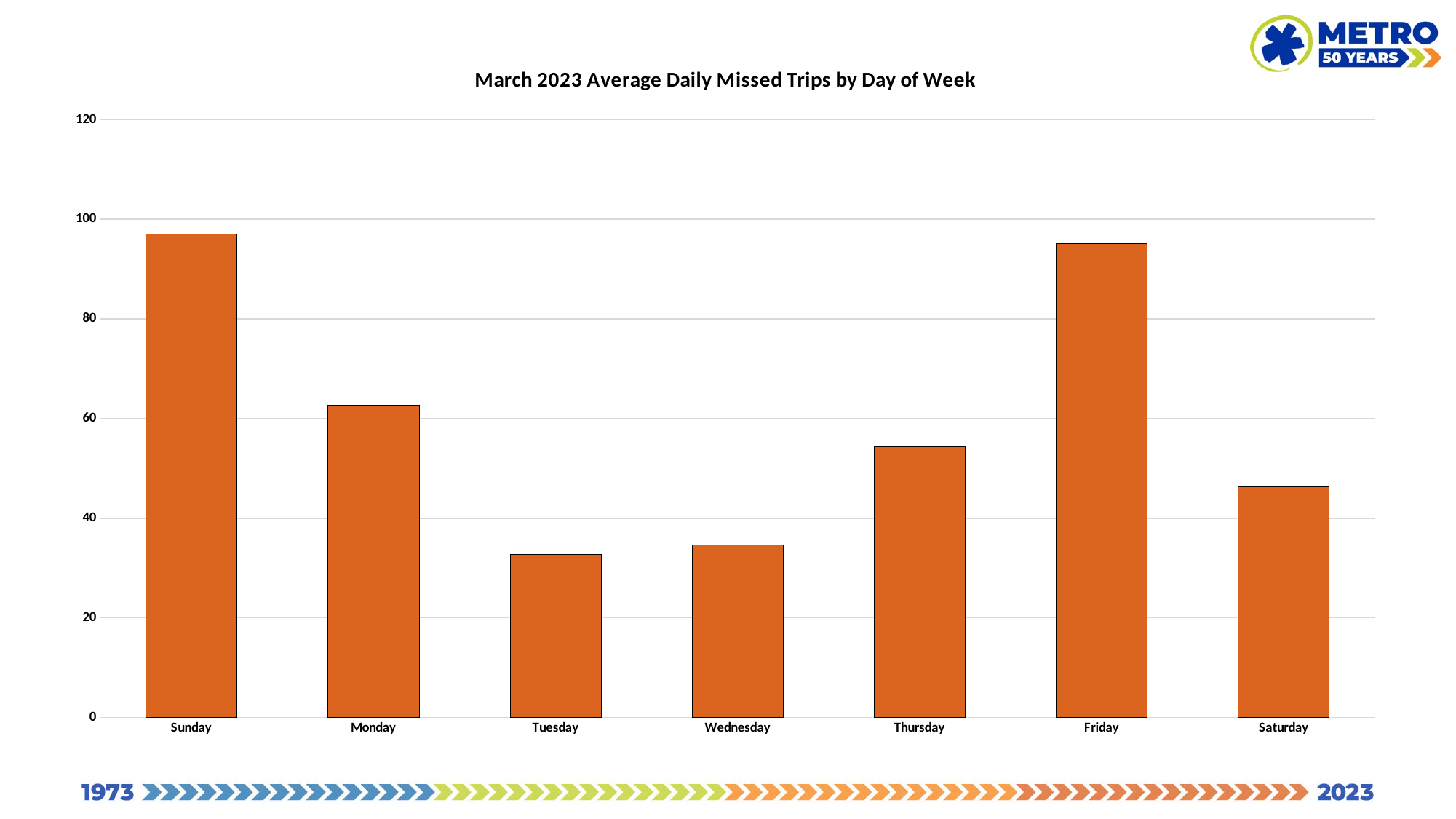
What is the title of the chart? March 2023 Average Daily Missed Trips by Day of Week Is the value for Monday greater or less than 80? less Which has a higher value, Monday or Tuesday? Monday Is the value for Saturday greater or less than 60? less Is the value for Tuesday greater or less than 40? less Which has a higher value, Thursday or Saturday? Thursday What kind of chart is shown on the slide? bar chart Which has a lower value, Wednesday or Friday? Wednesday How many days of the week are shown on the x axis of the chart? 7